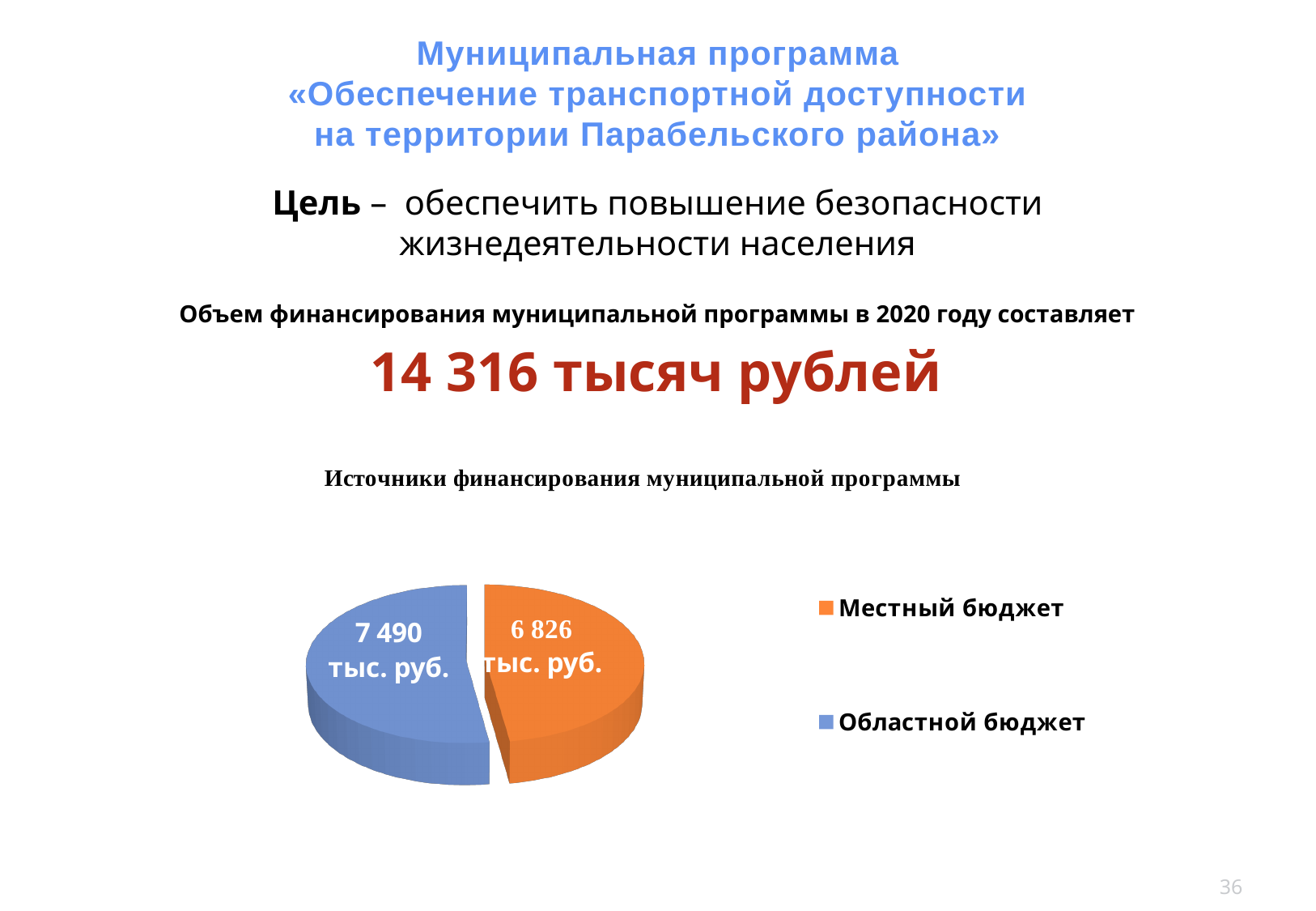
How many slices does the pie chart have? 2 By how much does Областной бюджет exceed Местный бюджет in the pie chart, in тыс. руб.? 664 What is the value for Местный бюджет in the pie chart? 6 826 тыс. руб. What colour is the Местный бюджет slice in the pie chart? orange What is the title of the pie chart? Источники финансирования муниципальной программы How many entries does the legend of the pie chart list? 2 What is the value for Областной бюджет in the pie chart? 7 490 тыс. руб. Which is larger in the pie chart: Местный бюджет or Областной бюджет? Областной бюджет What is the total of the two slices in the pie chart, in тыс. руб.? 14 316 What type of chart is shown under the title «Источники финансирования муниципальной программы»? pie chart Which funding source has the smallest slice in the pie chart? Местный бюджет Which funding source has the largest slice in the pie chart? Областной бюджет